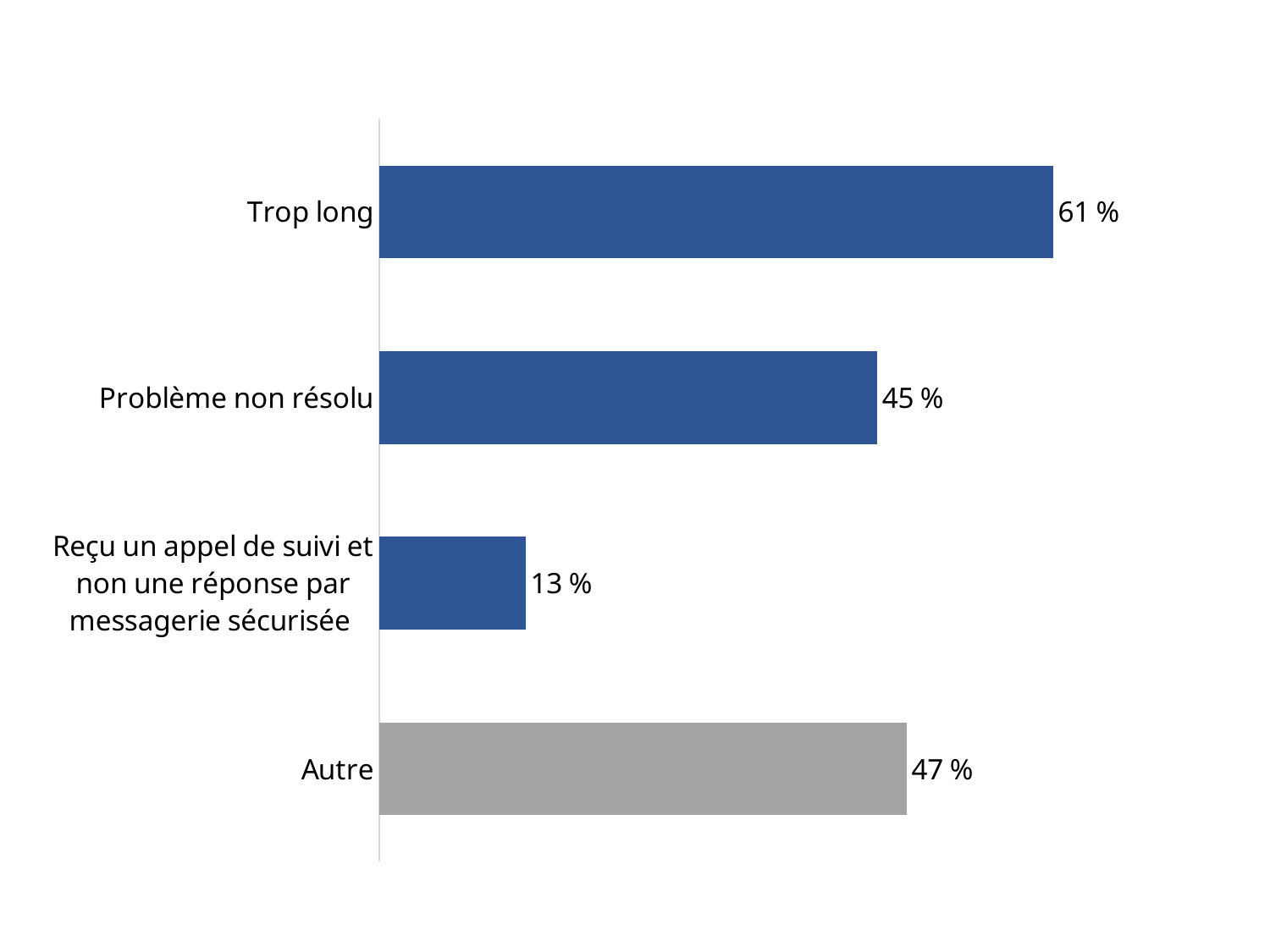
What is the value for "Problème non résolu"? 45 % Which bar is coloured grey rather than blue? Autre What is the value for "Autre"? 47 % Which category has the lowest value? Reçu un appel de suivi et non une réponse par messagerie sécurisée What is the value for "Reçu un appel de suivi et non une réponse par messagerie sécurisée"? 13 % What is the difference between the values for "Autre" and "Reçu un appel de suivi et non une réponse par messagerie sécurisée"? 34 % What is the difference between the values for "Trop long" and "Problème non résolu"? 16 % Which is larger, the value for "Autre" or the value for "Problème non résolu"? Autre How many categories are shown in the chart? 4 Which category has the highest value? Trop long What kind of chart is this? Bar chart What is the value for "Trop long"? 61 %